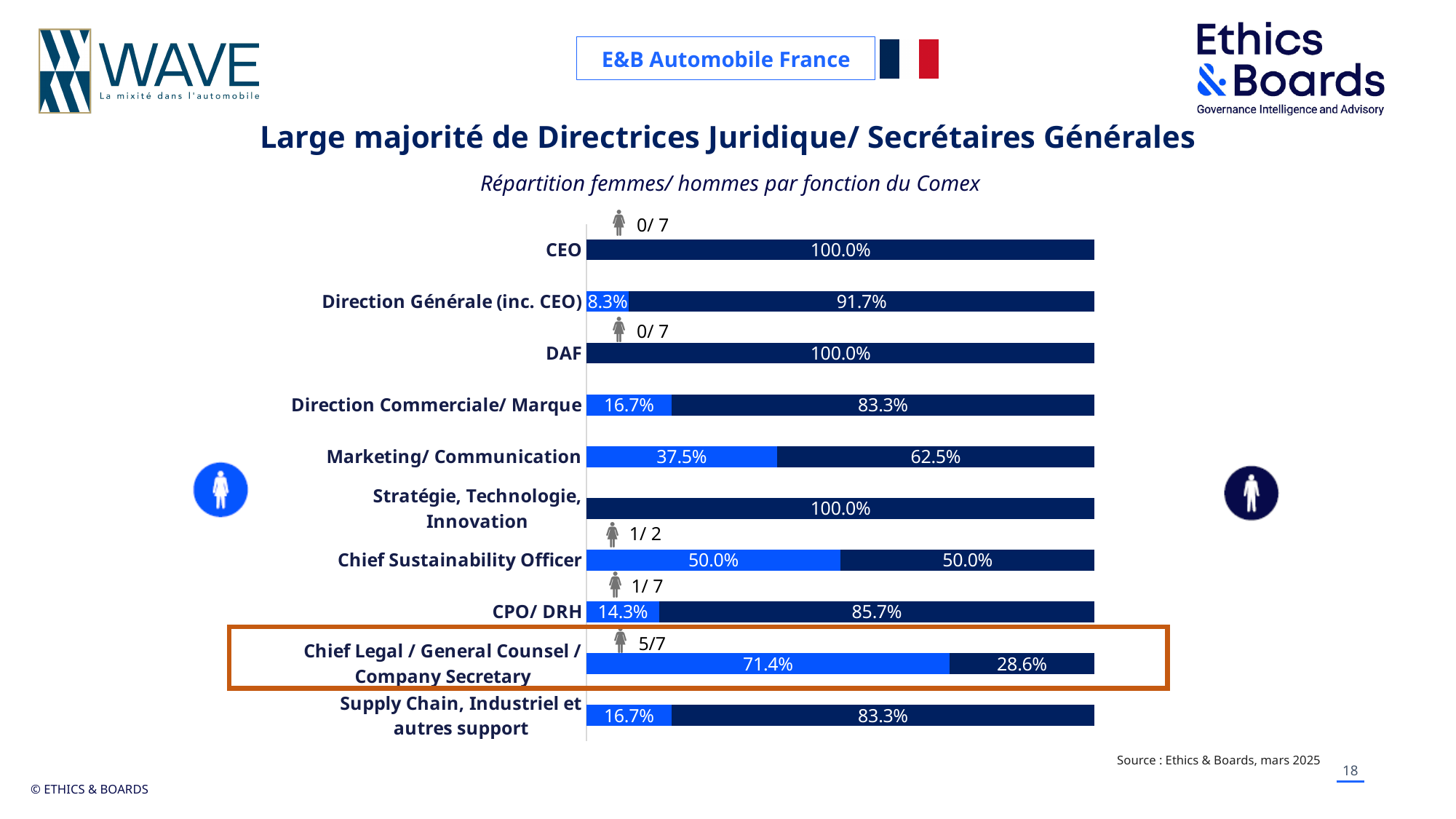
What percentage of women is shown for Marketing/ Communication? 37.5% What is the total of the stacked bar for Chief Sustainability Officer? 100.0% What is the women's share shown for Direction Générale (inc. CEO)? 8.3% What is the subtitle of the chart? Répartition femmes/ hommes par fonction du Comex What is the women's share shown for Chief Legal / General Counsel / Company Secretary? 71.4% How many Comex functions are shown in the chart? 10 For Marketing/ Communication, what is the difference between the men's share and the women's share? 25.0 percentage points Which has a larger share of women: Marketing/ Communication or Direction Commerciale/ Marque? Marketing/ Communication What kind of chart is shown on the slide? Stacked bar chart Which function has the highest share of women? Chief Legal / General Counsel / Company Secretary Which function has the lowest share of men? Chief Legal / General Counsel / Company Secretary What is the men's share shown for CPO/ DRH? 85.7%